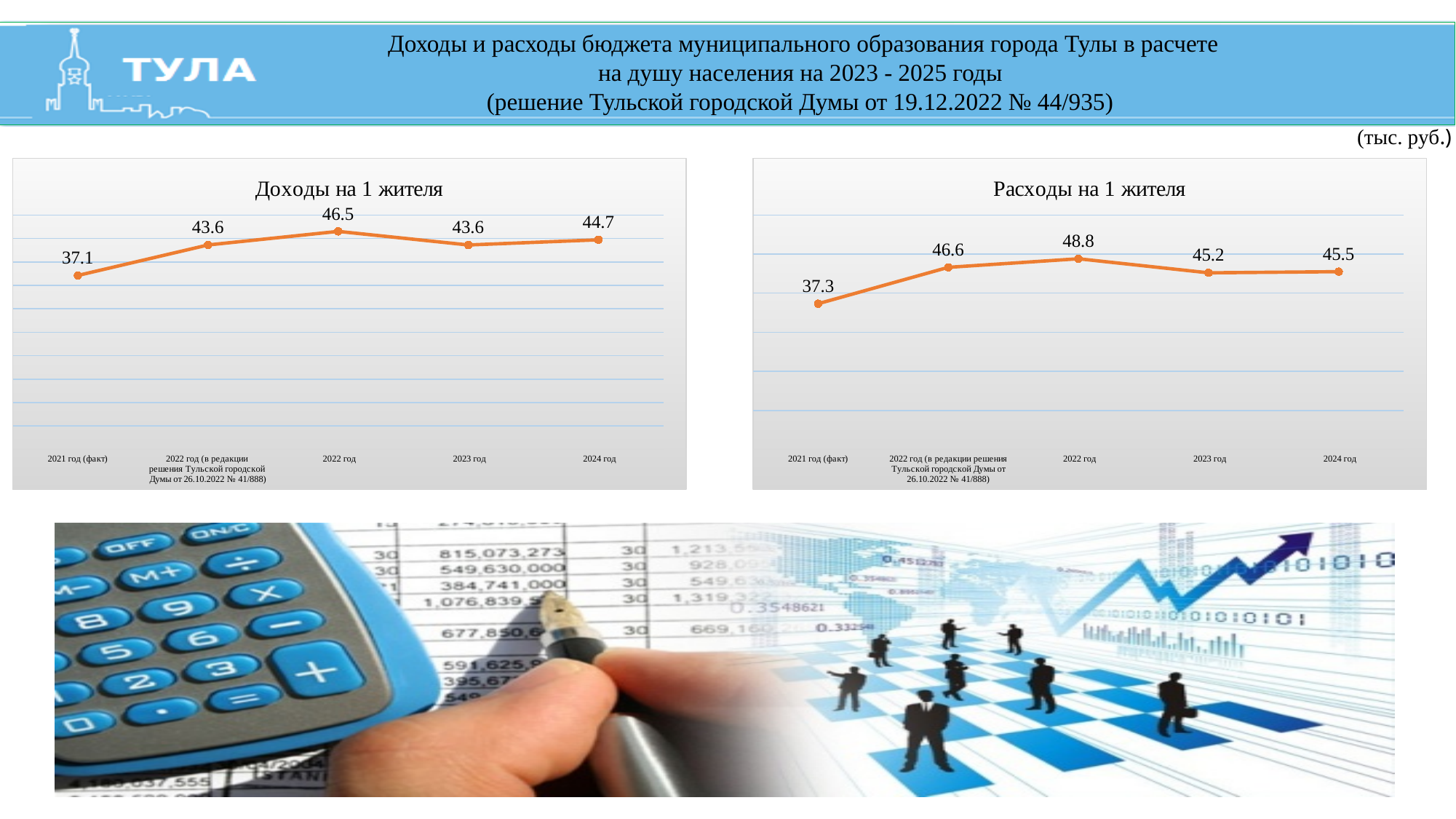
How many data points are plotted in the chart titled "Доходы на 1 жителя"? 5 In the chart titled "Расходы на 1 жителя", what is the value for 2023 год? 45.2 In the chart titled "Доходы на 1 жителя", which category has the highest value? 2022 год In the chart titled "Доходы на 1 жителя", what is the difference between the values for 2022 год and 2023 год? 2.9 In the chart titled "Расходы на 1 жителя", which category has the lowest value? 2021 год (факт) In the chart titled "Расходы на 1 жителя", what is the difference between the values for 2022 год and 2021 год (факт)? 11.5 In the chart titled "Доходы на 1 жителя", what is the value for 2024 год? 44.7 In the chart titled "Доходы на 1 жителя", what is the value for 2021 год (факт)? 37.1 In the chart titled "Расходы на 1 жителя", which is larger: the value for 2023 год or the value for 2024 год? 2024 год In the chart titled "Расходы на 1 жителя", what is the value for 2022 год? 48.8 In the chart titled "Доходы на 1 жителя", which category has the lowest value? 2021 год (факт) What kind of chart is the chart titled "Расходы на 1 жителя"? line chart